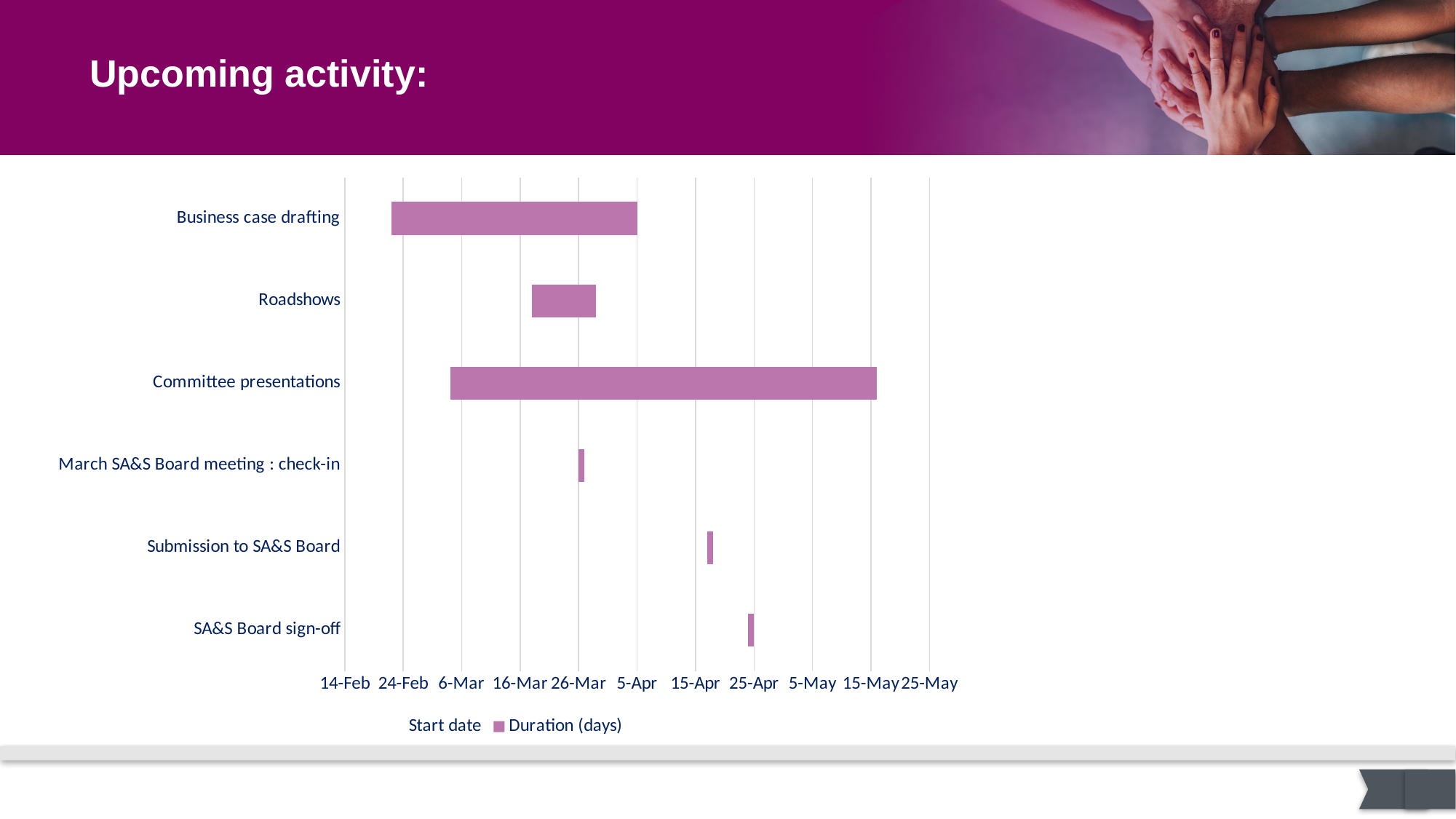
What kind of chart is shown on the slide? Bar chart What are the two legend entries? Start date, Duration (days) How many activities are listed on the chart? 6 What is the title of the slide? Upcoming activity: Which activity's bar starts latest on the date axis? SA&S Board sign-off Which has the longer bar, Business case drafting or Roadshows? Business case drafting Which activity's bar starts earliest on the date axis? Business case drafting Which activity has the longest bar (longest duration)? Committee presentations How many series does the legend list? 2 Does the Roadshows bar start before or after 16-Mar? after Does the Submission to SA&S Board bar fall before or after 15-Apr? after